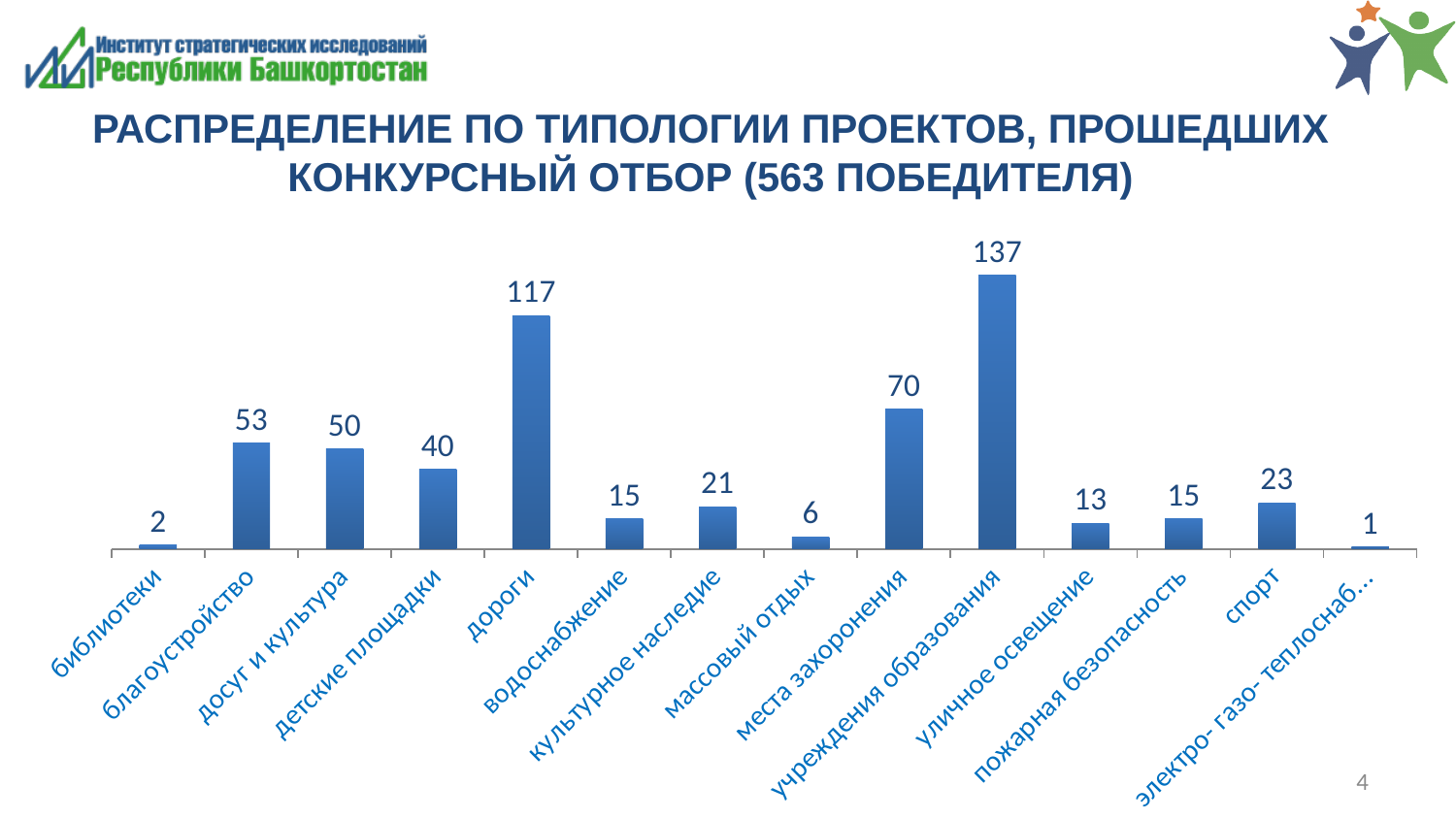
What is the difference between the values for учреждения образования and дороги? 20 What kind of chart is shown on the slide? bar chart Which category has the highest value? учреждения образования Which is larger, the value for массовый отдых or the value for уличное освещение? уличное освещение What is the total number of winners stated in the chart title? 563 What is the difference between the values for благоустройство and досуг и культура? 3 What is the value for места захоронения? 70 What is the value for детские площадки? 40 What is the value for дороги? 117 Which is larger, the value for спорт or the value for культурное наследие? спорт Which category has the lowest value? электро- газо- теплоснаб… How many categories are shown on the x axis? 14